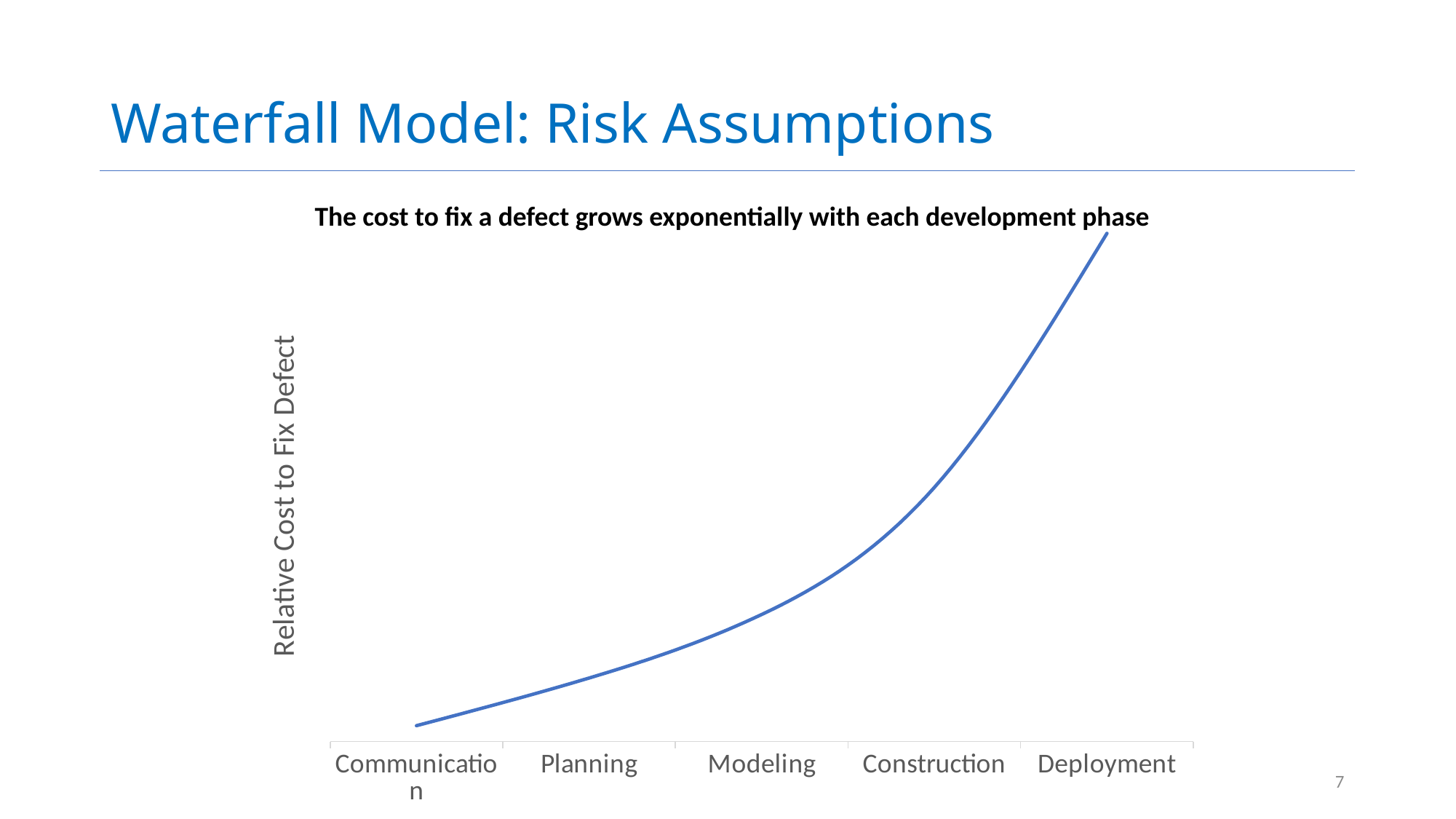
Which has a lower relative cost to fix a defect, Planning or Deployment? Planning Which has a higher relative cost to fix a defect, Modeling or Construction? Construction What is the title of the chart? The cost to fix a defect grows exponentially with each development phase What is the label on the vertical axis of the chart? Relative Cost to Fix Defect How many development phases are shown on the x axis? 5 Which phase comes immediately after Modeling on the x axis? Construction Which phase has the lowest relative cost to fix a defect? Communication Which phase has the highest relative cost to fix a defect? Deployment What kind of chart is shown on the slide? line chart Does the relative cost to fix a defect rise or fall from Communication to Deployment? rise